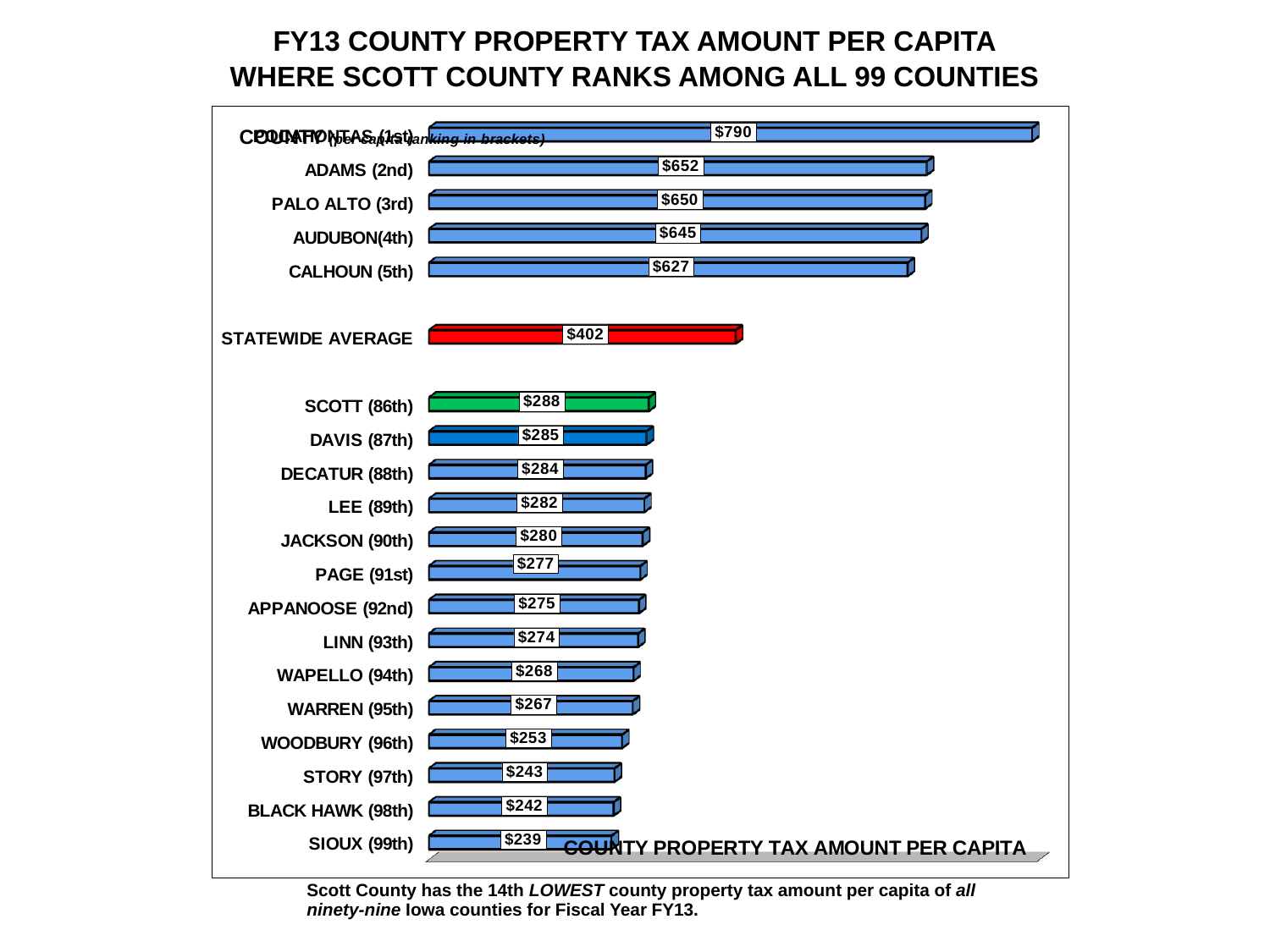
Which county has the lowest property tax amount per capita on the chart? SIOUX (99th) What is the value shown for the STATEWIDE AVERAGE bar? $402 Which is larger, the value for ADAMS (2nd) or PALO ALTO (3rd)? ADAMS (2nd) What kind of chart is shown on the slide? Bar chart What is the value shown for ADAMS (2nd)? $652 How much higher is the STATEWIDE AVERAGE than SCOTT (86th)? $114 How many bars are plotted on the chart? 20 What is the highest value shown on the chart? $790 What is the difference between ADAMS (2nd) and CALHOUN (5th)? $25 What is the value shown for BLACK HAWK (98th)? $242 What colour is the bar for SCOTT (86th)? Green What is the county property tax amount per capita for SCOTT (86th)? $288